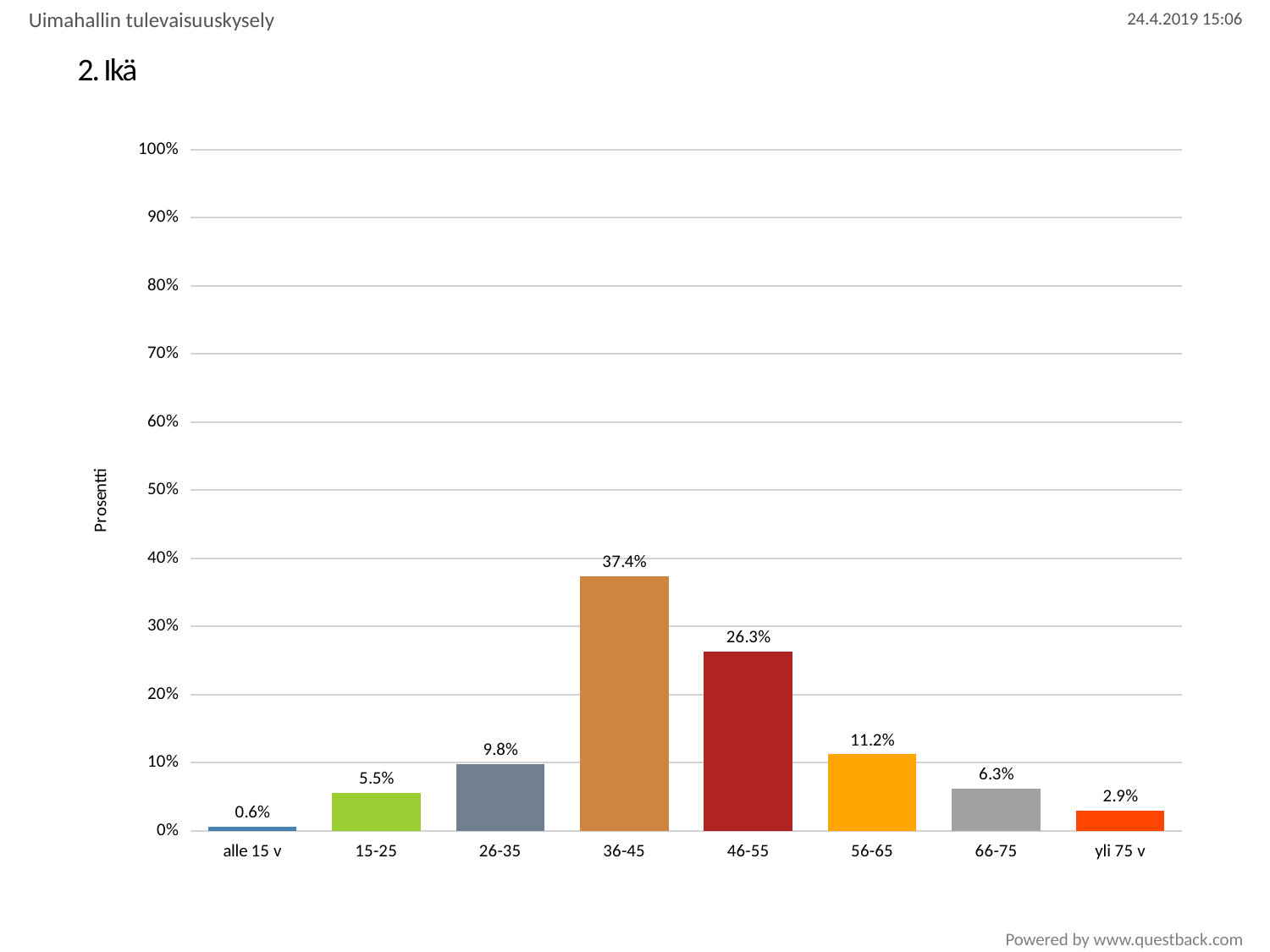
What is the title of the chart? 2. Ikä Which is larger, the value for 26-35 or the value for 66-75? 26-35 What is the value for the 'alle 15 v' category? 0.6% How many age categories are shown on the x axis? 8 What kind of chart is shown on the slide? bar chart Is the value for 46-55 greater or less than 20%? greater Which age group has the highest value? 36-45 What is the label of the y axis? Prosentti What is the value for the 36-45 age group? 37.4% What is the difference between the values for 36-45 and 46-55? 11.1% What is the value for the 56-65 age group? 11.2% Which age group has the lowest value? alle 15 v